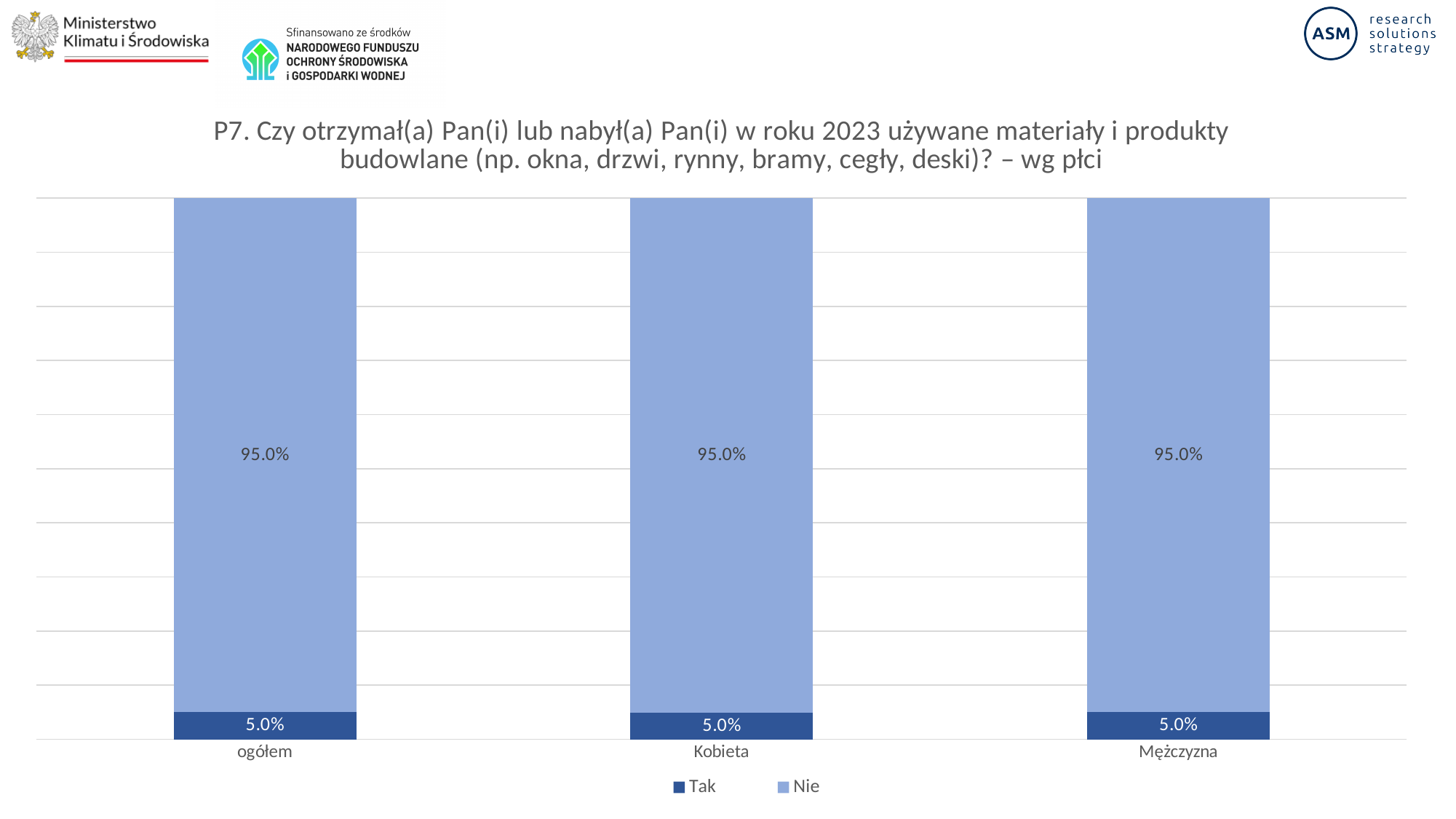
What is the total of the stacked bar for "ogółem"? 100.0% What is the value for "Nie" in the "Kobieta" category? 95.0% What kind of chart is shown on the slide? Stacked bar chart How many series does the legend list? 2 How many categories are shown on the x axis? 3 Does the "Tak" value change across the three categories? No, it is 5.0% in all three What is the value for "Nie" in the "ogółem" category? 95.0% Which series is shown in dark blue in the legend? Tak What is the difference between the "Nie" and "Tak" values in the "Kobieta" category? 90.0% What is the value for "Tak" in the "ogółem" category? 5.0% What is the value for "Tak" in the "Mężczyzna" category? 5.0% Which is larger in the "Mężczyzna" category, "Tak" or "Nie"? Nie